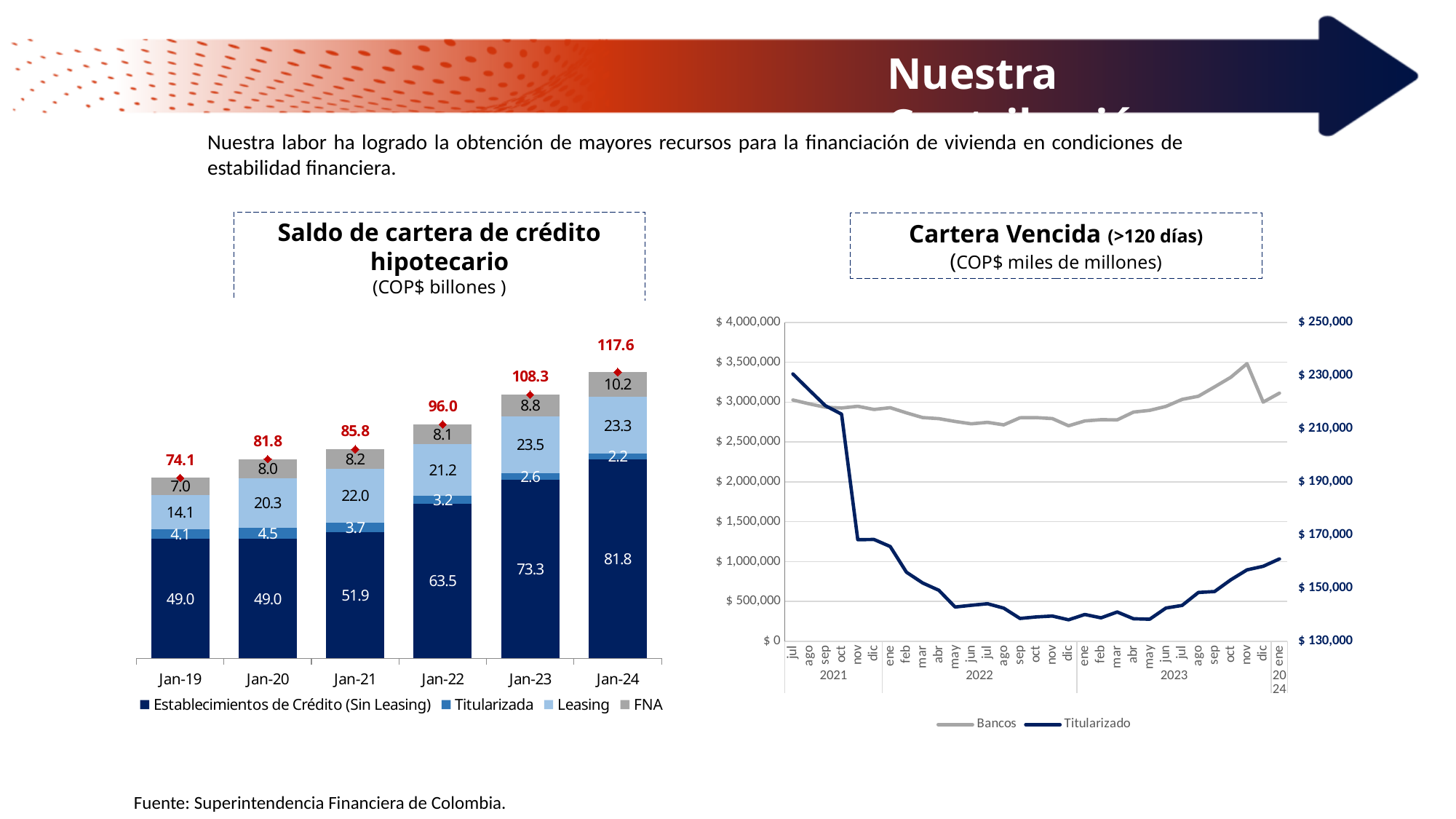
In the 'Saldo de cartera de crédito hipotecario' chart, which year has the highest total? Jan-24 In the 'Saldo de cartera de crédito hipotecario' chart, which year has the lowest Titularizada value? Jan-24 What kind of chart is the 'Cartera Vencida (>120 días)' chart? Line chart In the 'Saldo de cartera de crédito hipotecario' chart, which is larger: the Establecimientos de Crédito (Sin Leasing) value for Jan-22 or for Jan-21? Jan-22 In the 'Saldo de cartera de crédito hipotecario' chart, what is the total value shown for Jan-24? 117.6 In the 'Saldo de cartera de crédito hipotecario' chart, what is the Titularizada value for Jan-21? 3.7 In the 'Saldo de cartera de crédito hipotecario' chart, what is the Leasing value for Jan-23? 23.5 In the 'Saldo de cartera de crédito hipotecario' chart, what is the difference between the totals for Jan-24 and Jan-23? 9.3 How many years are shown on the x axis of the 'Saldo de cartera de crédito hipotecario' chart? 6 In the 'Saldo de cartera de crédito hipotecario' chart, what is the FNA value for Jan-19? 7.0 How many series does the legend of the 'Saldo de cartera de crédito hipotecario' chart list? 4 In the 'Cartera Vencida (>120 días)' chart, does the Titularizado line rise or fall between jul 2021 and dic 2021? Fall